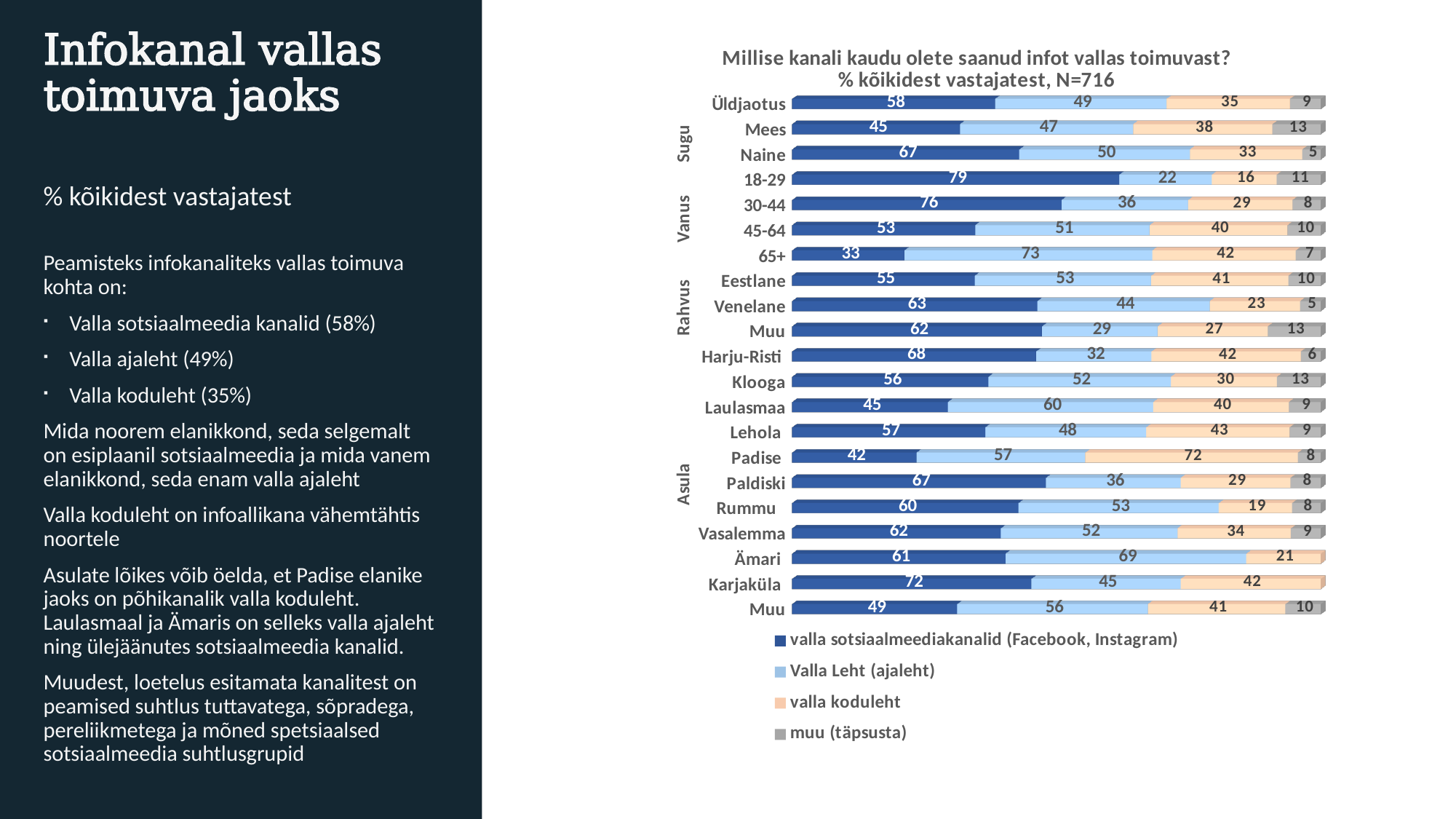
What is the value for muu (täpsusta) for Mees? 13 Which category has the lowest value for valla sotsiaalmeediakanalid (Facebook, Instagram)? 65+ What is the sum of the four values shown on the Üldjaotus bar? 151 What is the value for Valla Leht (ajaleht) in the 65+ age group? 73 How many series does the legend list? 4 Which category has the highest value for valla sotsiaalmeediakanalid (Facebook, Instagram)? 18-29 What kind of chart is shown on the slide? Stacked bar chart What is the value for valla sotsiaalmeediakanalid (Facebook, Instagram) in the 18-29 age group? 79 What is the difference between the valla sotsiaalmeediakanalid values for Naine and Mees? 22 What is the value for valla koduleht for Padise? 72 What is the value for valla koduleht for Rummu? 19 Which has a larger value for Valla Leht (ajaleht): Laulasmaa or Klooga? Laulasmaa